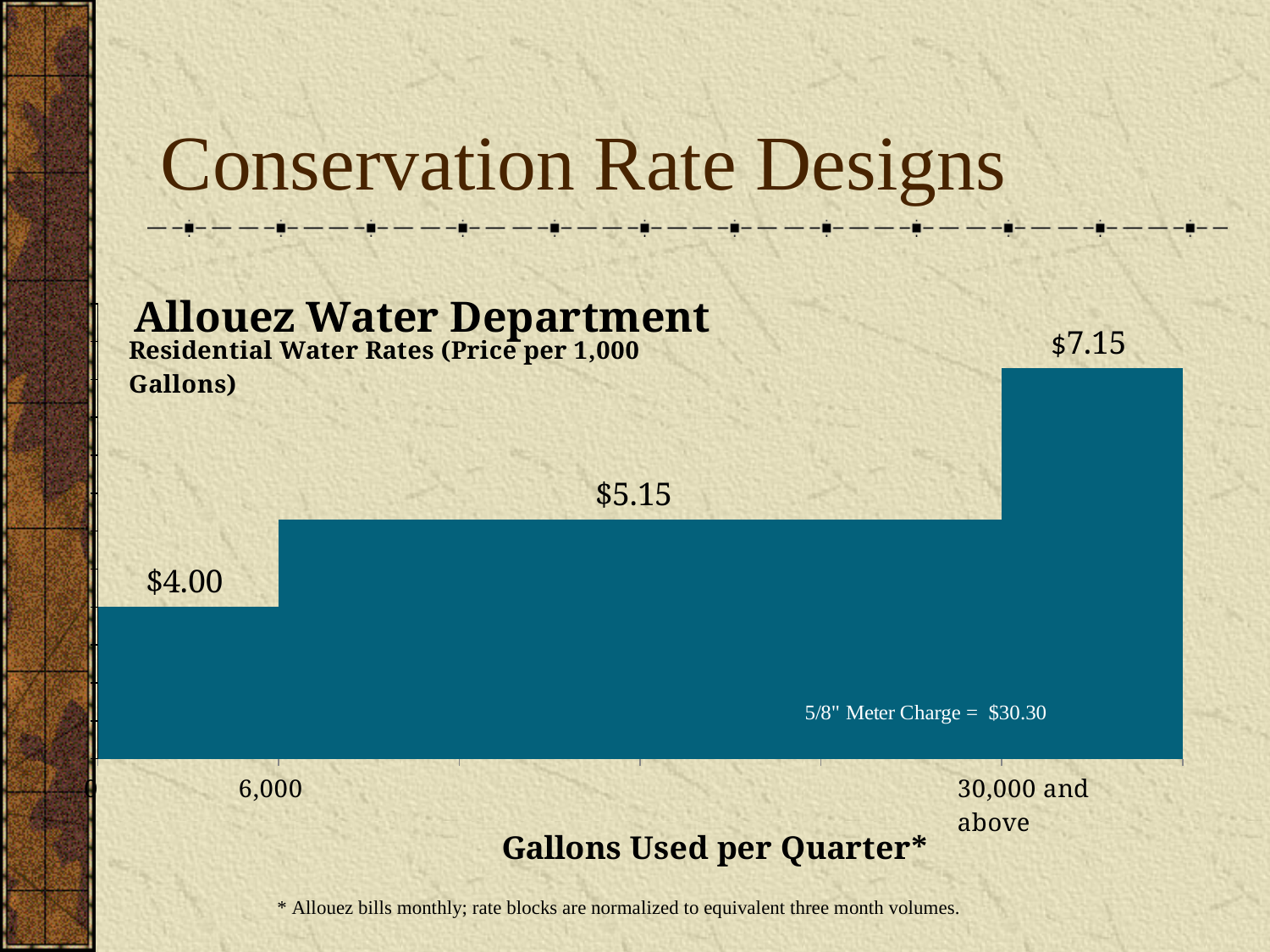
Which rate block has the lowest price per 1,000 gallons? 0 to 6,000 gallons What is the difference between the highest rate ($7.15) and the lowest rate ($4.00)? $3.15 What is the difference between the middle block rate and the first block rate? $1.15 Which rate block has the highest price per 1,000 gallons? 30,000 and above How many rate blocks are shown in the chart? 3 What is the price per 1,000 gallons for the '30,000 and above' rate block? $7.15 What is the price per 1,000 gallons for the middle rate block (6,000 to 30,000 gallons)? $5.15 Which is larger, the rate for the middle block or the rate for the '30,000 and above' block? 30,000 and above Do the rates rise or fall as gallons used per quarter increases? Rise What is the 5/8" meter charge shown on the chart? $30.30 What is the label of the x axis of the chart? Gallons Used per Quarter* What is the price per 1,000 gallons for the first rate block (0 to 6,000 gallons)? $4.00